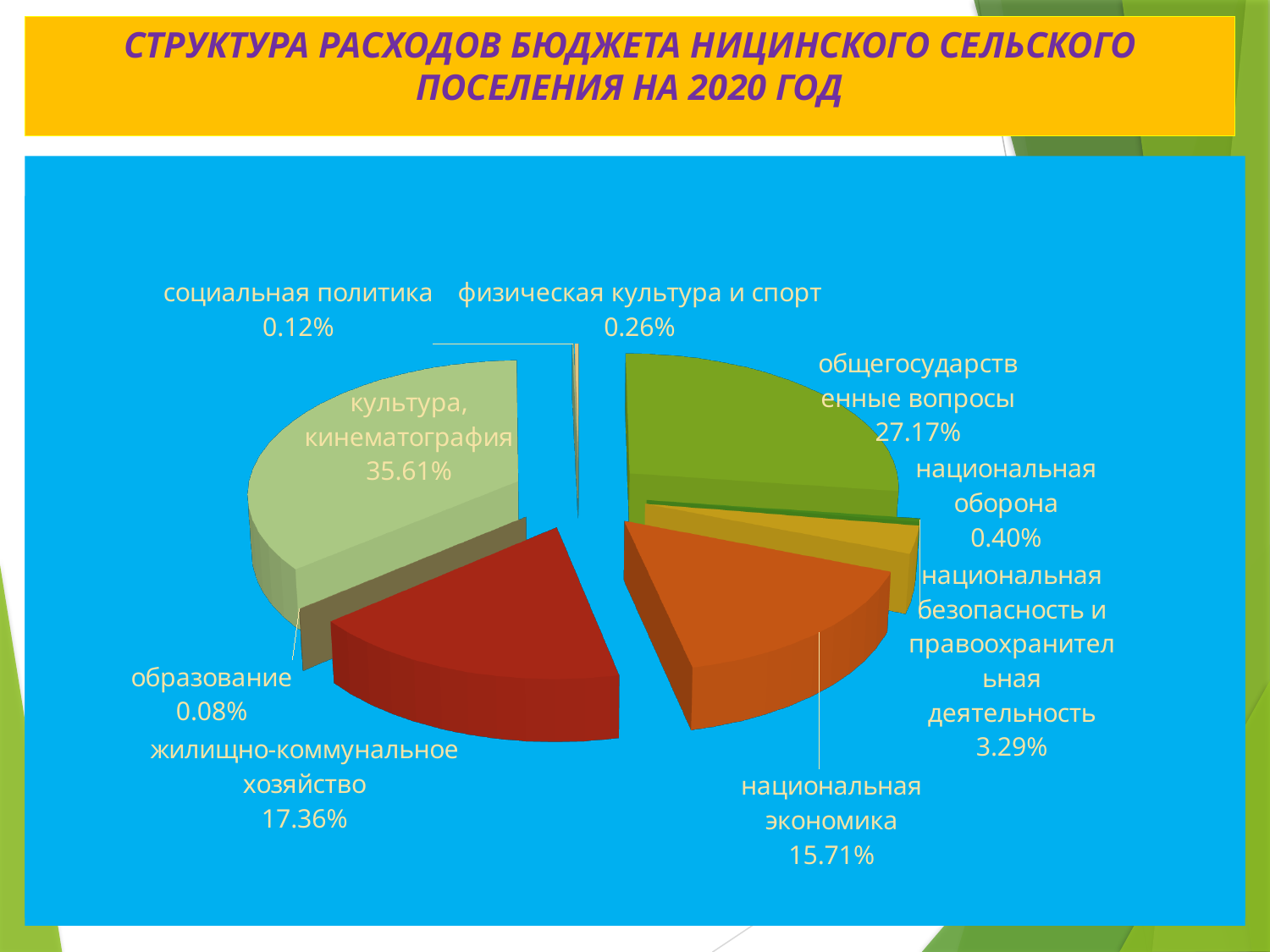
What is the title of the chart on the slide? СТРУКТУРА РАСХОДОВ БЮДЖЕТА НИЦИНСКОГО СЕЛЬСКОГО ПОСЕЛЕНИЯ НА 2020 ГОД What share of the budget expenditures goes to культура, кинематография? 35.61% What kind of chart is shown on the slide? pie chart What is the difference between the shares of общегосударственные вопросы and национальная экономика? 11.46% What is the value shown for общегосударственные вопросы? 27.17% What share is shown for национальная безопасность и правоохранительная деятельность? 3.29% Which category has the largest share of the pie? культура, кинематография What is the value for национальная экономика? 15.71% Which category has the smallest share of the pie? образование Which is larger: the share for жилищно-коммунальное хозяйство or for национальная экономика? жилищно-коммунальное хозяйство What percentage is shown for жилищно-коммунальное хозяйство? 17.36% How many categories are shown in the pie chart? 9